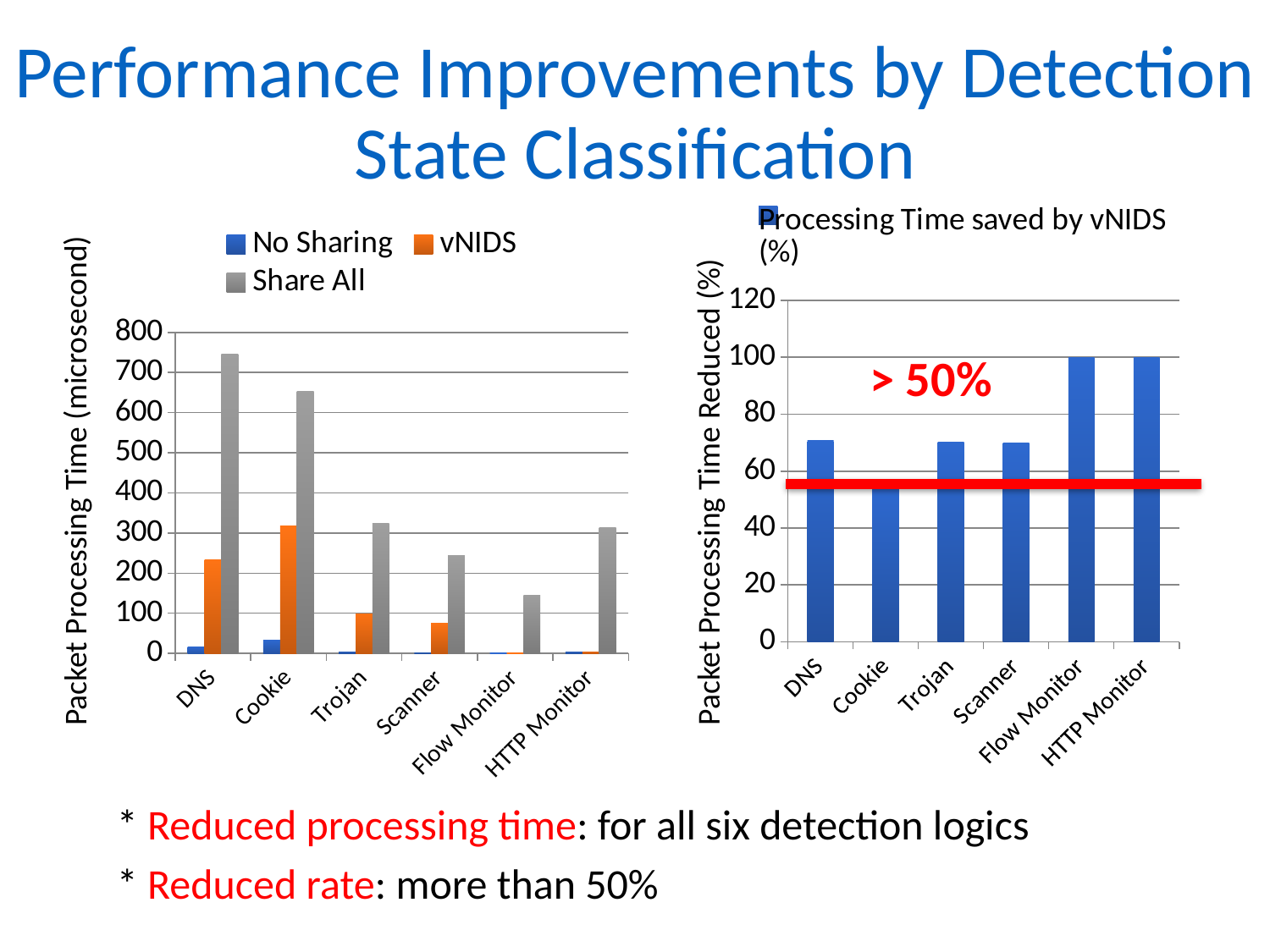
In the left chart, is the Share All value for Flow Monitor greater or less than 200? less In the left chart, which category has the highest Share All value? DNS In the right chart (Processing Time saved by vNIDS), what is the value for Flow Monitor? 100 What kind of chart is the left chart showing Packet Processing Time (microsecond)? bar chart In the right chart (Processing Time saved by vNIDS), which category has the lowest value? Cookie In the left chart, which is larger: the vNIDS value for Cookie or the vNIDS value for DNS? Cookie In the right chart (Processing Time saved by vNIDS), is the value for DNS greater or less than 60? greater How many series does the legend of the left chart list? 3 In the left chart, is the vNIDS value for Cookie greater or less than 300? greater How many detection logic categories are shown on the x axis of the left chart? 6 What threshold label is written in red on the right chart? > 50%